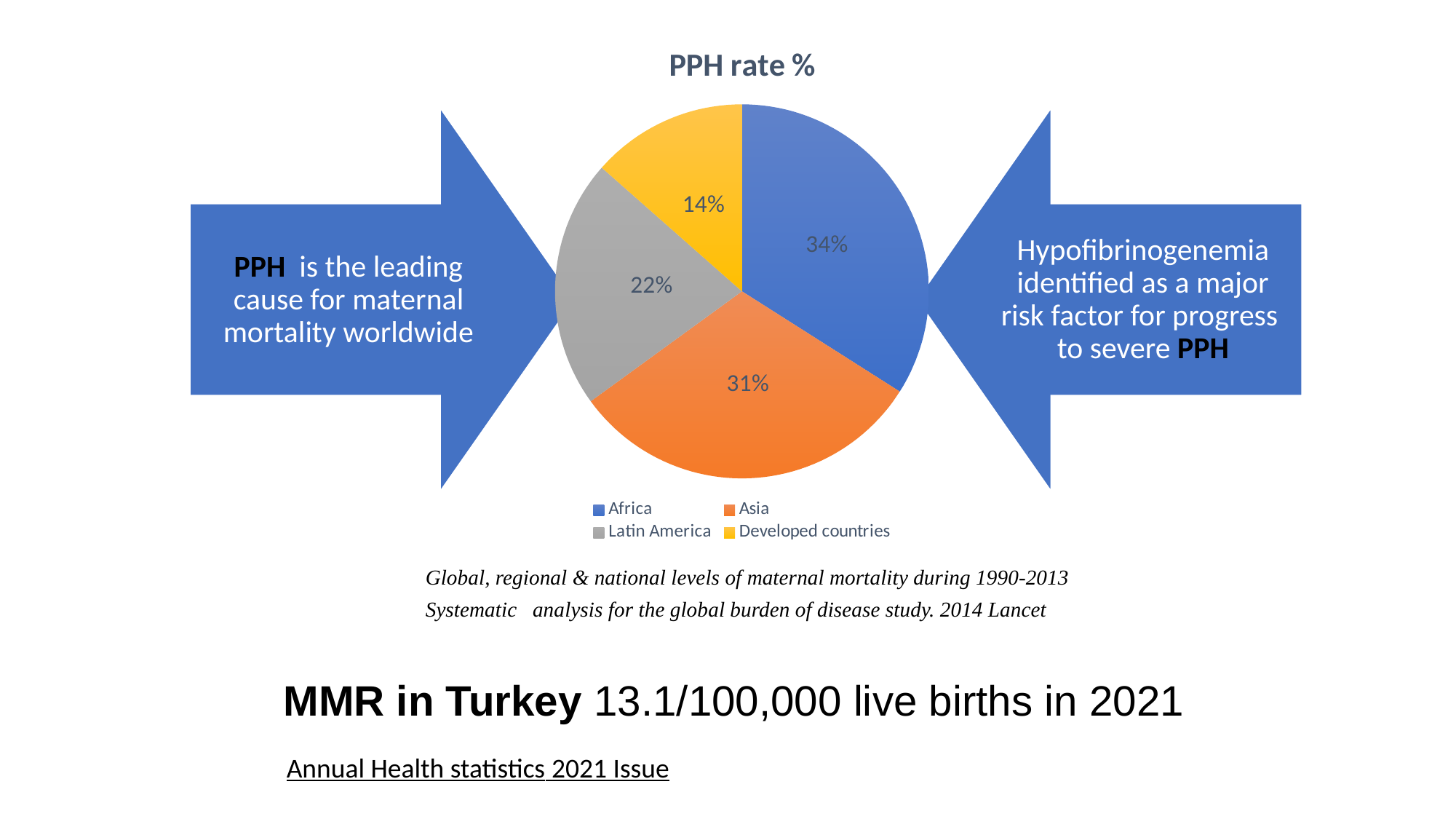
What colour is the slice for Latin America? grey What is the PPH rate for Asia? 31% Which region has the smallest share of the pie? Developed countries What is the PPH rate for Latin America? 22% Which region has the largest share of the pie? Africa What is the PPH rate for Developed countries? 14% What type of chart is shown on the slide? pie chart Which has a larger PPH rate, Latin America or Asia? Asia What is the PPH rate for Africa? 34% What is the title of the chart? PPH rate % What is the difference between the PPH rate for Africa and for Developed countries? 20% How many regions are shown in the pie chart? 4